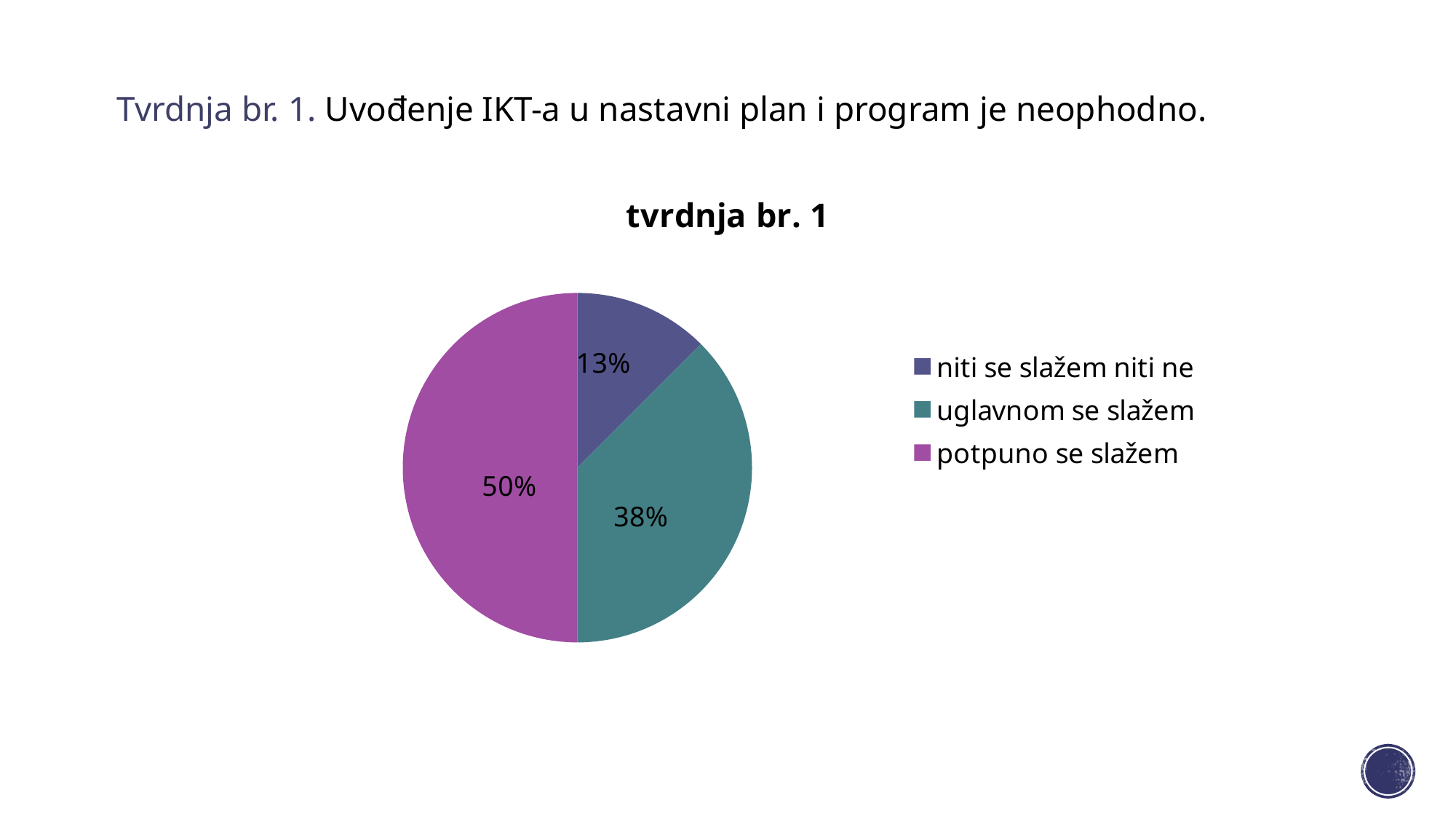
What kind of chart is shown on the slide? pie chart What is the chart's title? tvrdnja br. 1 What is the difference between the shares for "uglavnom se slažem" and "niti se slažem niti ne"? 25% Which category has the smallest slice of the pie? niti se slažem niti ne What share of the pie is labelled "uglavnom se slažem"? 38% What colour is the slice for "potpuno se slažem"? purple What is the difference between the shares for "potpuno se slažem" and "uglavnom se slažem"? 12% How many categories does the legend list? 3 Which category has the largest slice of the pie? potpuno se slažem What share of the pie is labelled "potpuno se slažem"? 50% Which is larger, the share for "uglavnom se slažem" or the share for "niti se slažem niti ne"? uglavnom se slažem What share of the pie is labelled "niti se slažem niti ne"? 13%